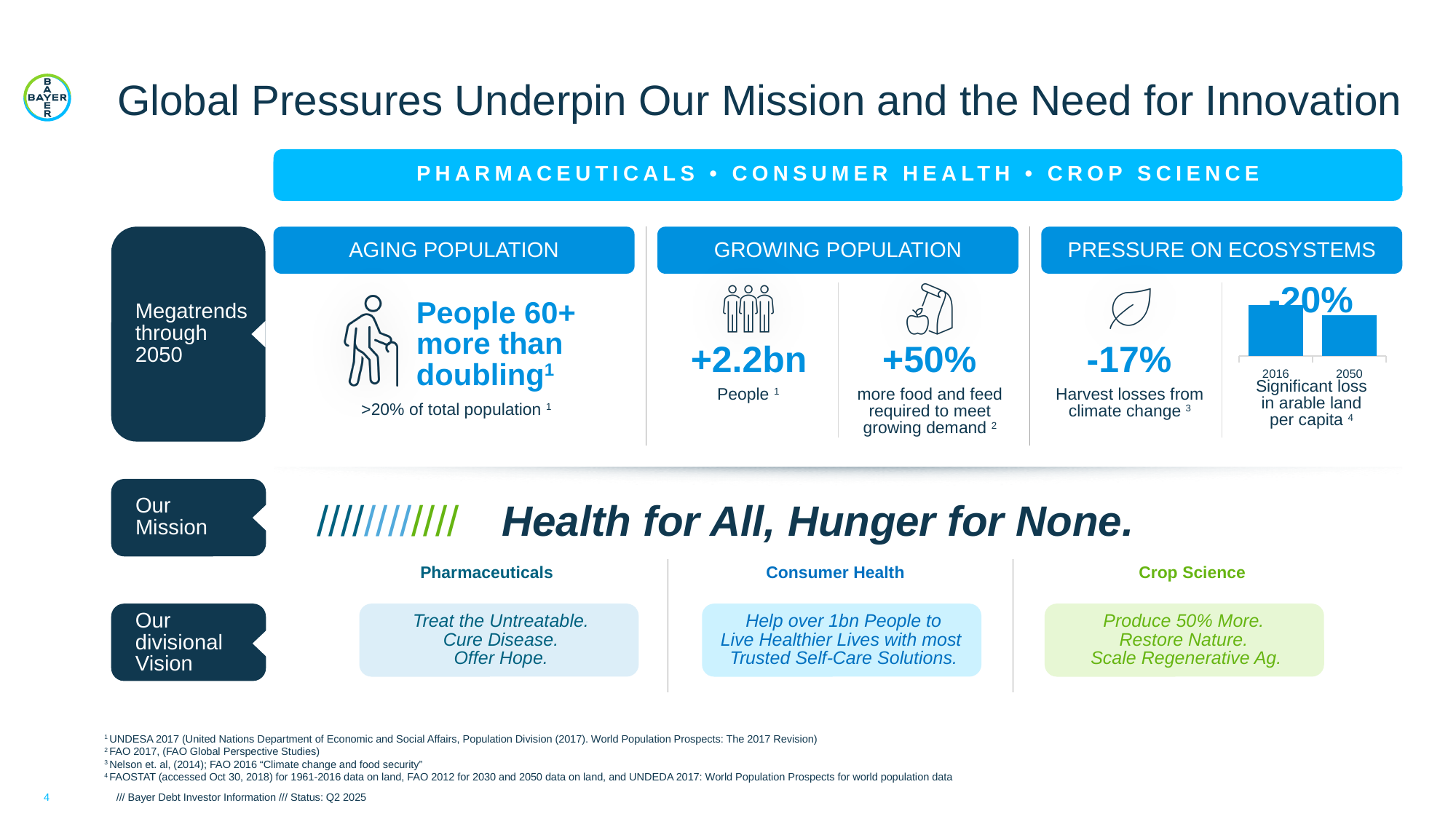
How many bars does the arable land per capita chart show? 2 Which year has the lowest bar in the arable land per capita chart? 2050 What kind of chart is shown under 'Pressure on Ecosystems'? bar chart In the arable land per capita chart, which bar is taller, 2016 or 2050? 2016 Which years are labelled on the x axis of the arable land per capita chart? 2016 and 2050 Which year has the highest bar in the arable land per capita chart? 2016 Do the bars in the arable land per capita chart rise or fall from 2016 to 2050? fall What percentage change is printed above the arable land per capita chart? -20%